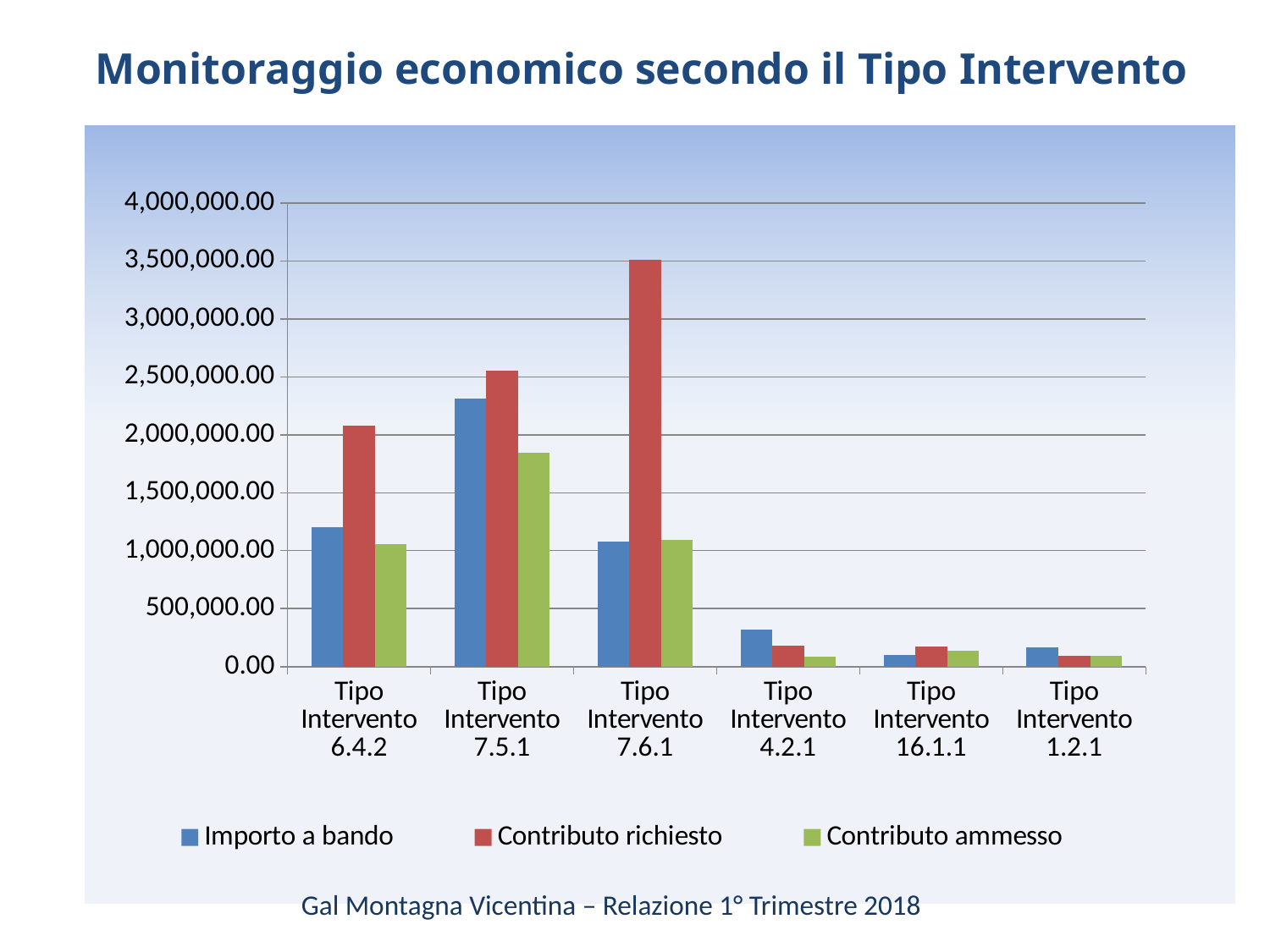
What colour represents the Contributo ammesso series in the legend? green Is the Contributo richiesto for Tipo Intervento 7.6.1 greater or less than 3,000,000.00? greater What kind of chart is shown on the slide? bar chart Is the Importo a bando for Tipo Intervento 4.2.1 greater or less than 500,000.00? less Is the Importo a bando for Tipo Intervento 6.4.2 greater or less than 1,000,000.00? greater How many series does the legend list? 3 Which Tipo Intervento has the highest Contributo richiesto? Tipo Intervento 7.6.1 For Tipo Intervento 6.4.2, which is larger: Contributo richiesto or Contributo ammesso? Contributo richiesto Which Tipo Intervento has the highest Importo a bando? Tipo Intervento 7.5.1 How many Tipo Intervento categories are shown on the x axis? 6 For Tipo Intervento 7.5.1, which is larger: Importo a bando or Contributo richiesto? Contributo richiesto